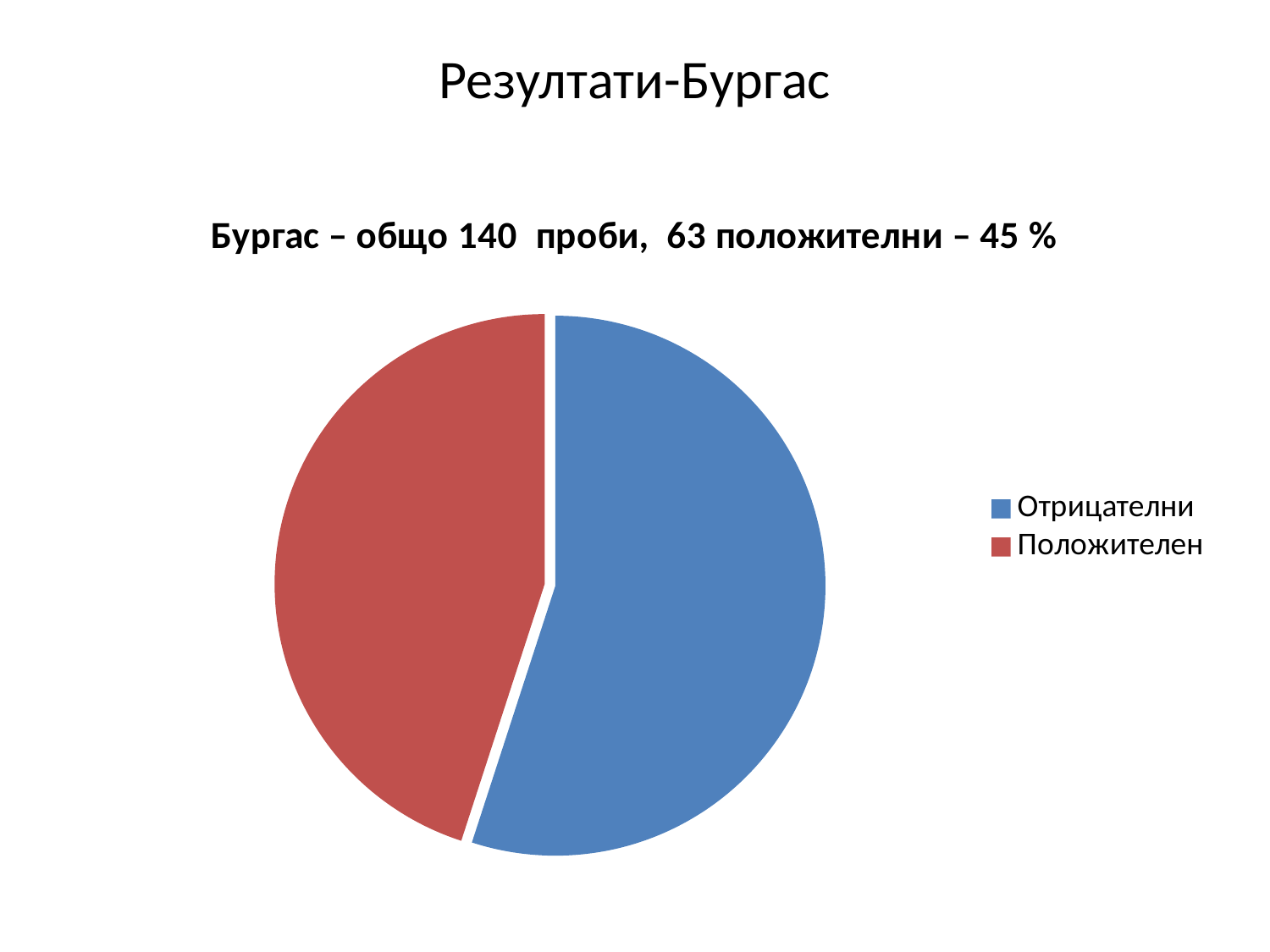
How many slices does the pie chart have? 2 Which slice of the pie chart is the smallest? Положителен How many entries does the legend list? 2 According to the chart title, how many samples in total were tested in Бургас? 140 What colour is used for the Отрицателни slice? blue Which slice of the pie chart is the largest? Отрицателни Which slice is larger, Отрицателни or Положителен? Отрицателни According to the chart title, how many samples were positive (положителни)? 63 What is the title of the chart? Бургас – общо 140 проби, 63 положителни – 45 % Using the total of 140 samples and 63 positive samples from the title, how many samples were negative? 77 What share of the samples were positive, according to the chart title? 45 % What kind of chart is shown on the slide? pie chart